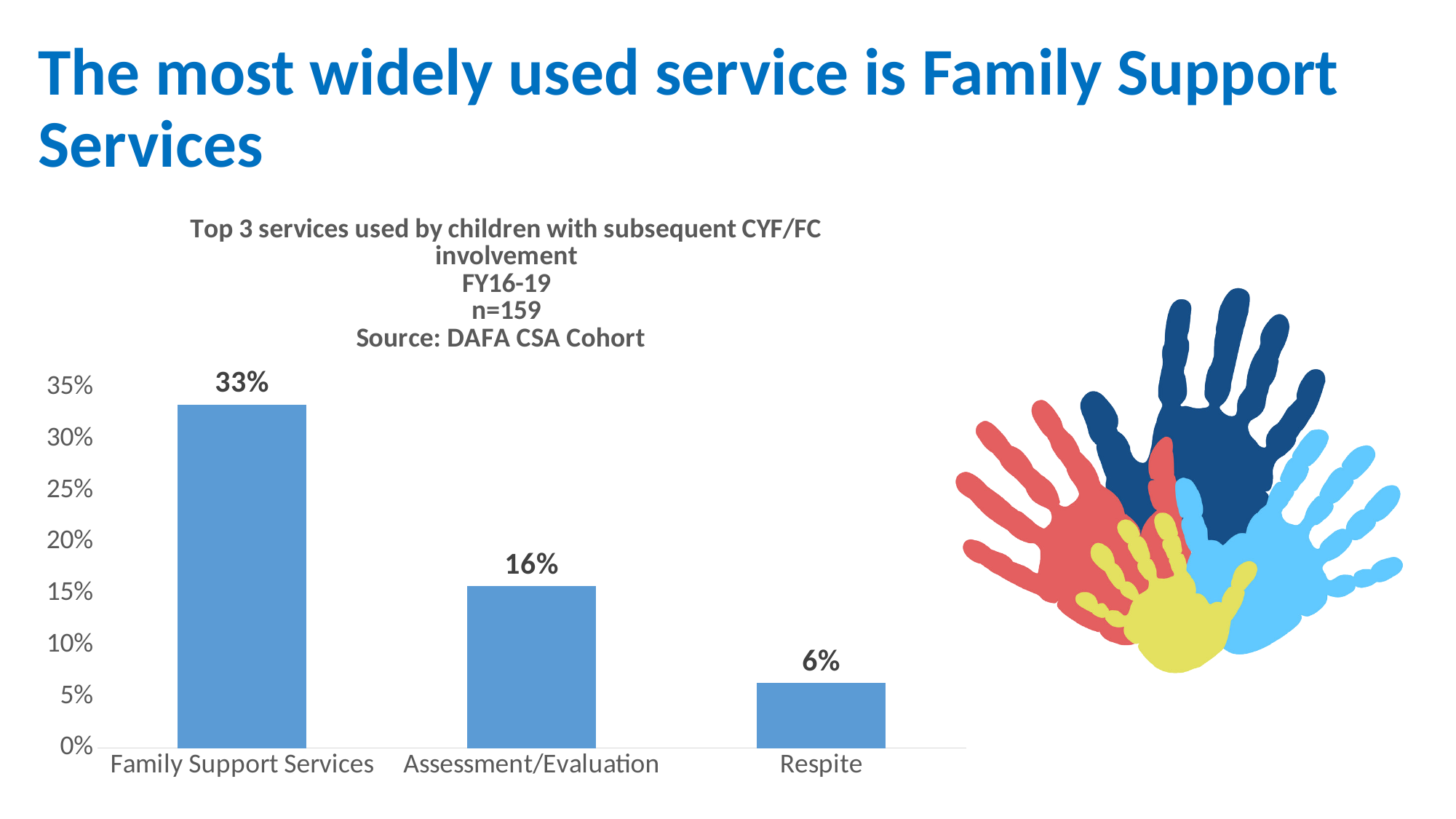
How many services are shown in the chart? 3 What is the difference between the values for Assessment/Evaluation and Respite? 10% What kind of chart is shown on the slide? bar chart What is the value for Respite? 6% Is the value for Family Support Services greater or less than 30%? greater What is the sample size (n) stated in the chart title? n=159 Which service has the lowest value? Respite Which is larger, the value for Assessment/Evaluation or the value for Respite? Assessment/Evaluation What is the value for Family Support Services? 33% Which service has the highest value? Family Support Services What is the value for Assessment/Evaluation? 16% What is the difference between the values for Family Support Services and Assessment/Evaluation? 17%